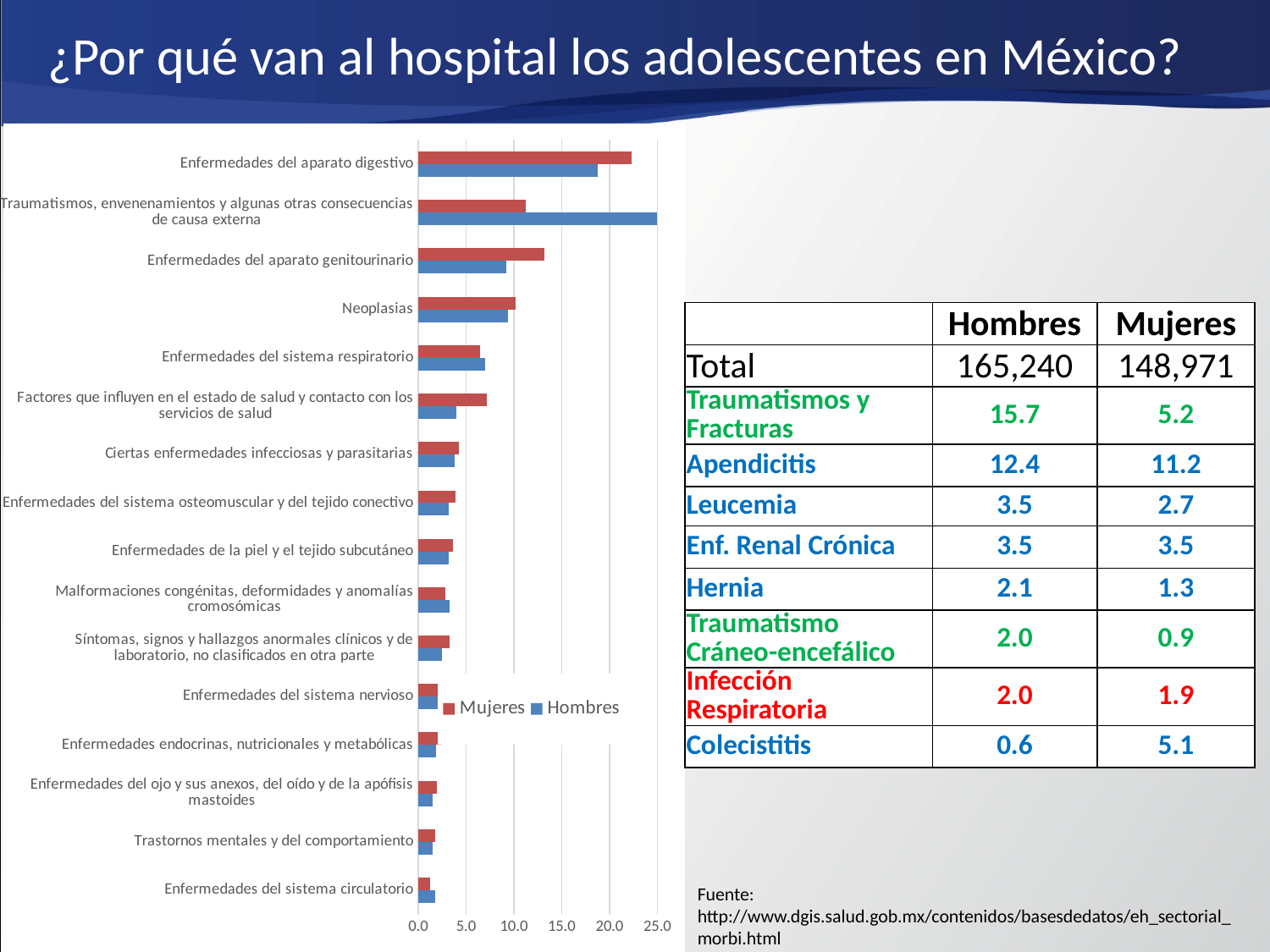
Which category has the highest value for the Mujeres series? Enfermedades del aparato digestivo Which two series are listed in the chart's legend? Mujeres and Hombres What kind of chart is shown on the slide? bar chart How many series does the chart's legend list? 2 Is the Hombres value for Traumatismos, envenenamientos y algunas otras consecuencias de causa externa greater or less than 20.0? greater For Enfermedades del aparato genitourinario, which series has the larger value, Mujeres or Hombres? Mujeres Which category has the highest value for the Hombres series? Traumatismos, envenenamientos y algunas otras consecuencias de causa externa For Factores que influyen en el estado de salud y contacto con los servicios de salud, which series has the larger value, Mujeres or Hombres? Mujeres Is the Mujeres value for Traumatismos, envenenamientos y algunas otras consecuencias de causa externa greater or less than 15.0? less Which colour represents the Hombres series in the chart? blue How many categories (diagnosis groups) are plotted on the chart? 16 Is the Mujeres value for Enfermedades del aparato digestivo greater or less than 20.0? greater